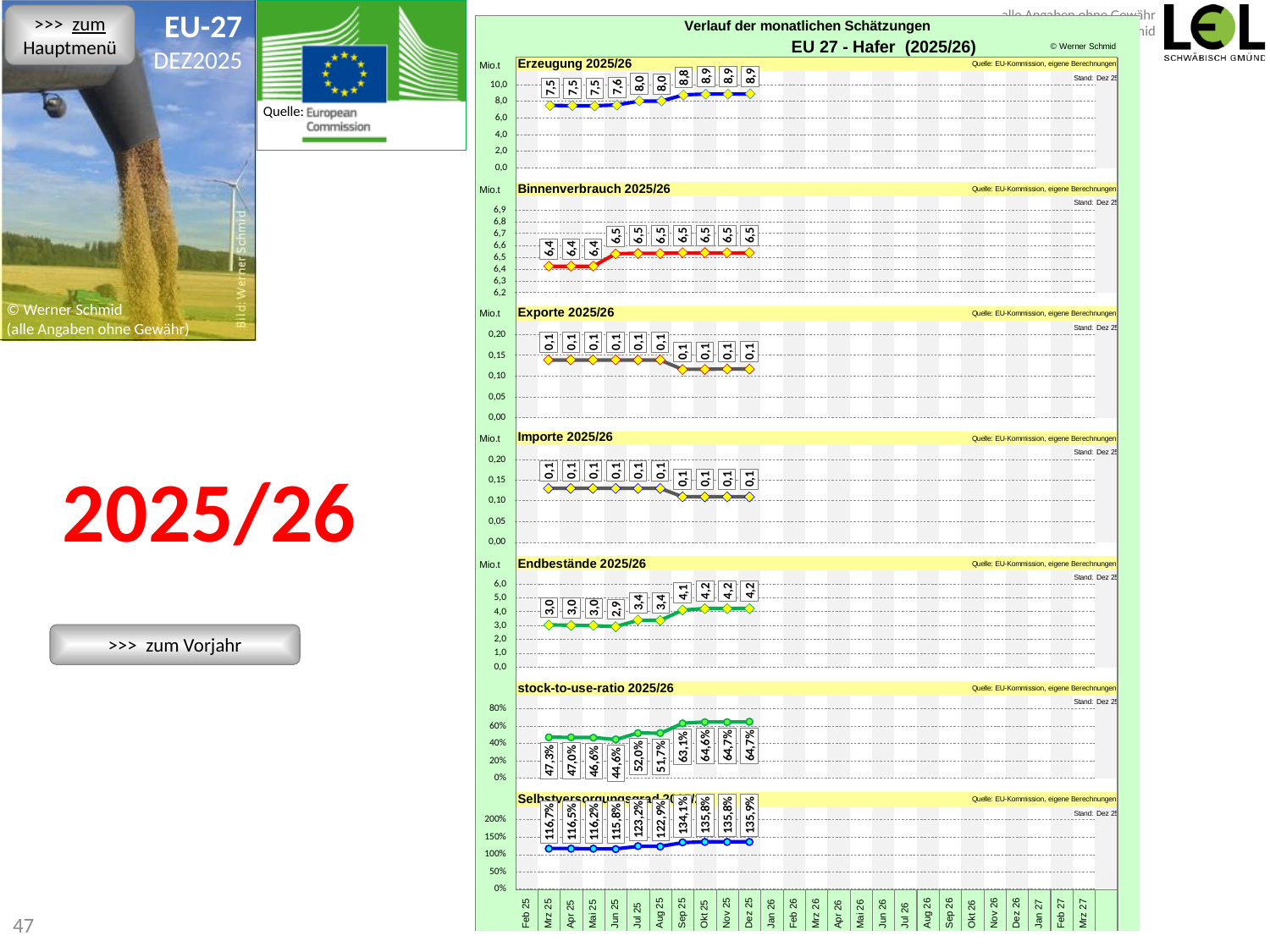
How many data points are plotted in the 'Exporte 2025/26' chart? 10 In the 'stock-to-use-ratio 2025/26' chart, what is the value for Sep 25? 63,1% In the 'Erzeugung 2025/26' chart, do the values rise or fall from Mrz 25 to Dez 25? rise In the 'Erzeugung 2025/26' chart, what is the value for Dez 25? 8,9 In the 'stock-to-use-ratio 2025/26' chart, which month has the lowest value? Jun 25 In the 'Selbstversorgungsgrad' chart, what is the value for Dez 25? 135,9% What kind of chart is the 'Selbstversorgungsgrad' chart? line chart In the 'Erzeugung 2025/26' chart, what is the difference between the Dez 25 value and the Mrz 25 value? 1,4 In the 'Binnenverbrauch 2025/26' chart, what is the value for Mrz 25? 6,4 In the 'Endbestände 2025/26' chart, what is the value for Jun 25? 2,9 In the 'Endbestände 2025/26' chart, which is larger, the value for Jul 25 or the value for Sep 25? Sep 25 In the 'Endbestände 2025/26' chart, which month has the lowest value? Jun 25